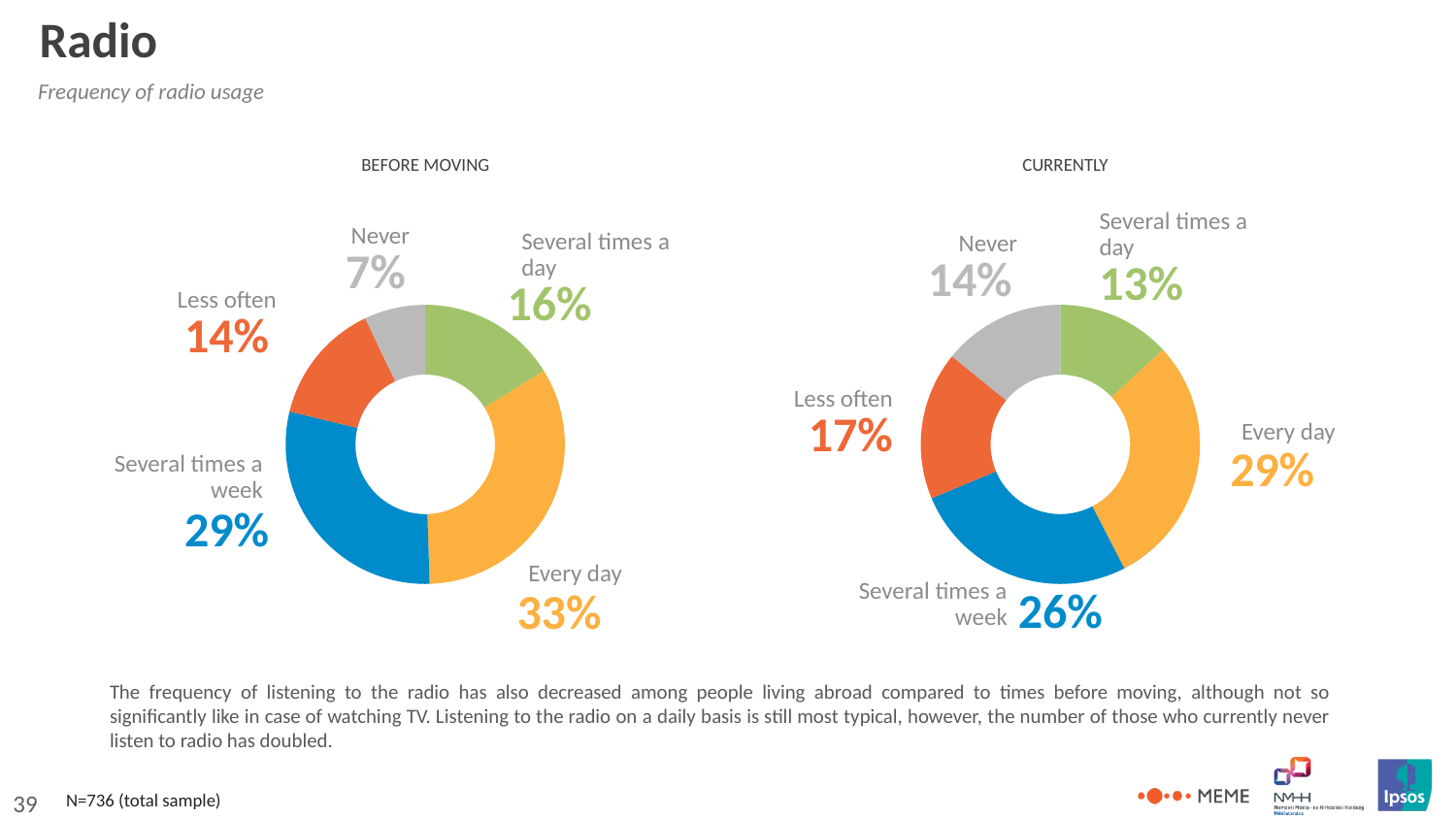
In the CURRENTLY chart, which category has the largest share? Every day In the BEFORE MOVING chart, which category has the largest share? Every day In the CURRENTLY chart, what percentage is shown for Less often? 17% What is the difference between the Every day share in the BEFORE MOVING chart and the Every day share in the CURRENTLY chart? 4% In the BEFORE MOVING chart, what percentage is shown for Every day? 33% In the BEFORE MOVING chart, which category has the smallest share? Never In the CURRENTLY chart, which category has the smallest share? Several times a day What is the subtitle of the slide describing the charts? Frequency of radio usage In the CURRENTLY chart, what percentage is shown for Never? 14% What type of chart is used on this slide? Doughnut (pie) chart How many categories does the CURRENTLY chart show? 5 In the BEFORE MOVING chart, which is larger: Several times a day or Less often? Several times a day